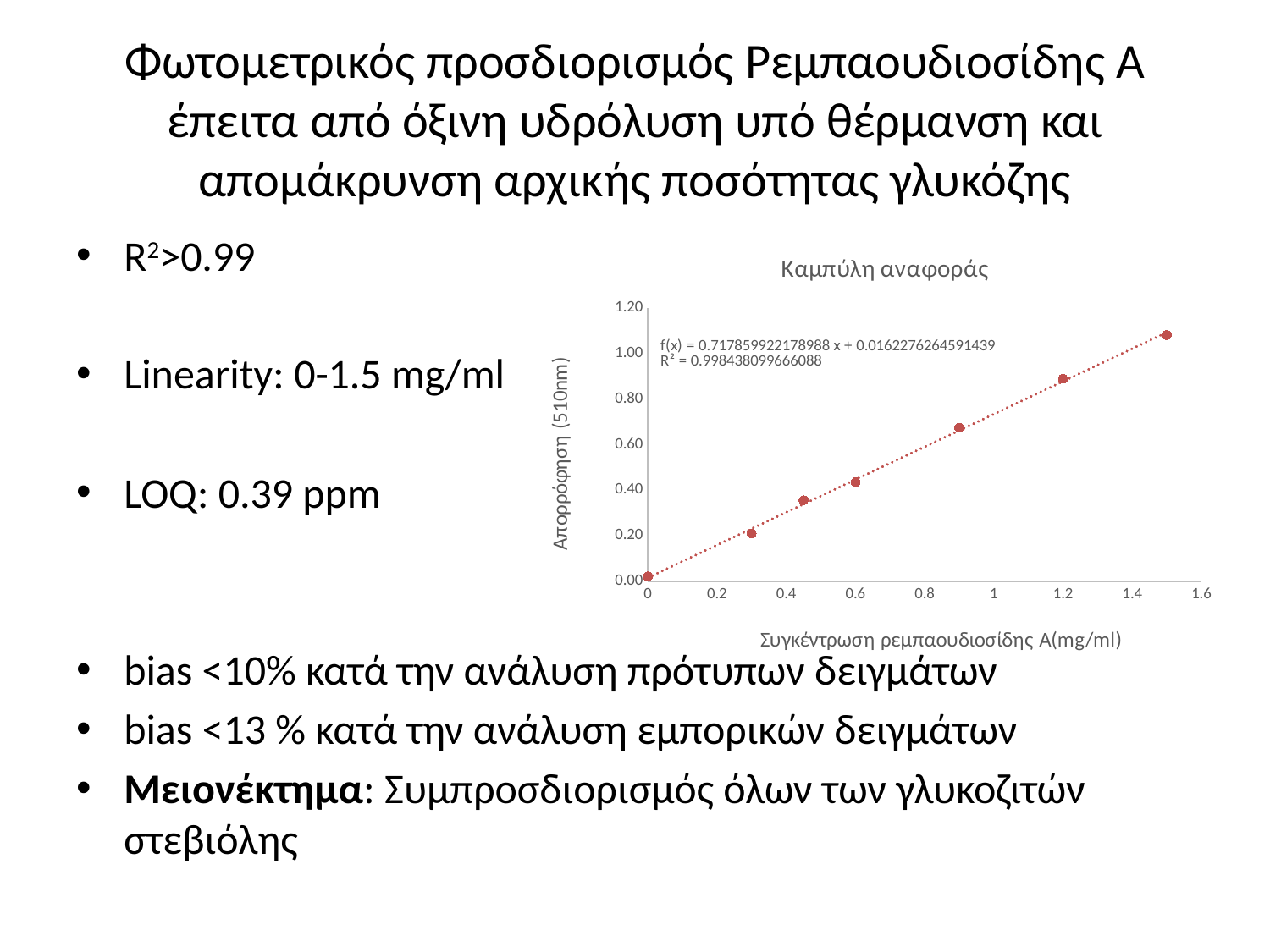
Is the absorbance value at concentration 0.9 greater or less than 0.60? greater What kind of chart is shown on the slide? Scatter chart At which concentration (x value) is the lowest absorbance point plotted? 0 Is the absorbance value at concentration 0.45 greater or less than 0.40? less At which concentration (x value) is the highest absorbance point plotted? 1.5 What is the title of the chart? Καμπύλη αναφοράς What is the label of the y axis of the chart? Απορρόφηση (510nm) Which has the higher absorbance: the point at concentration 0.6 or the point at concentration 1.2? 1.2 How many data points are plotted on the chart? 7 Is the absorbance value at concentration 1.5 greater or less than 1.00? greater Do the plotted values rise or fall as the concentration increases along the x axis? Rise